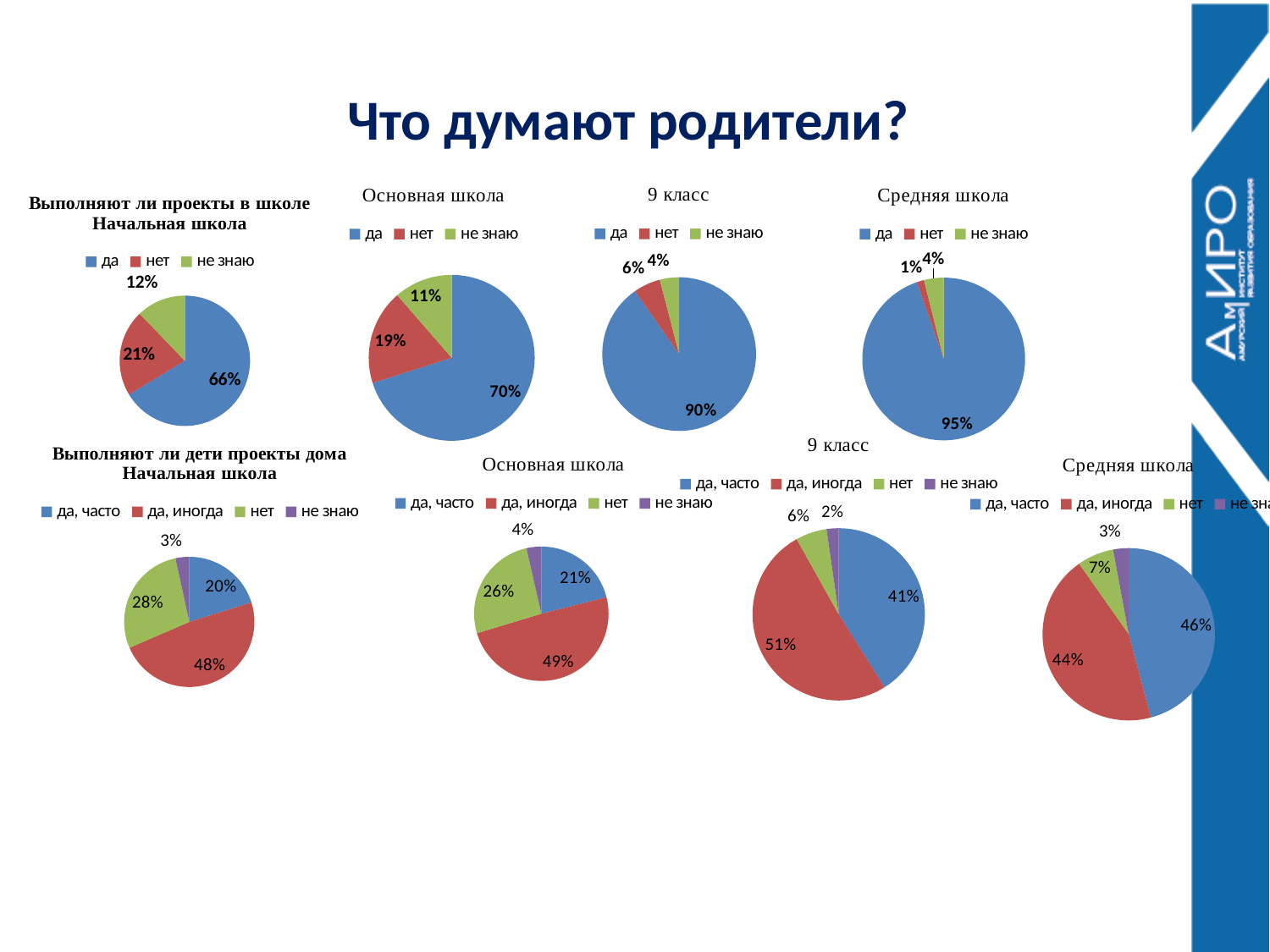
In the top-row pie chart titled "Основная школа", what share is labelled for "нет"? 19% What type of chart is used for "Выполняют ли проекты в школе Начальная школа"? Pie chart In the bottom-row pie chart titled "9 класс", what share is labelled for "да, иногда"? 51% How many pie charts are shown on the slide in total? 8 In the bottom-row pie chart titled "Выполняют ли дети проекты дома Начальная школа", what share is labelled for "да, иногда"? 48% In the top-row pie chart titled "Средняя школа", what is the difference between the "да" share and the "не знаю" share? 91% In the bottom-row pie chart titled "Основная школа", which is larger: "да, часто" or "нет"? нет In the top-row pie chart titled "Выполняют ли проекты в школе Начальная школа", what share is labelled for "да"? 66% In the top-row pie chart titled "9 класс", which category has the largest slice? да In the top-row pie chart titled "Средняя школа", which category has the smallest slice? нет In the bottom-row pie chart titled "Средняя школа", what is the difference between the "да, часто" share and the "да, иногда" share? 2% How many entries does the legend list in the bottom-row pie chart titled "Основная школа"? 4